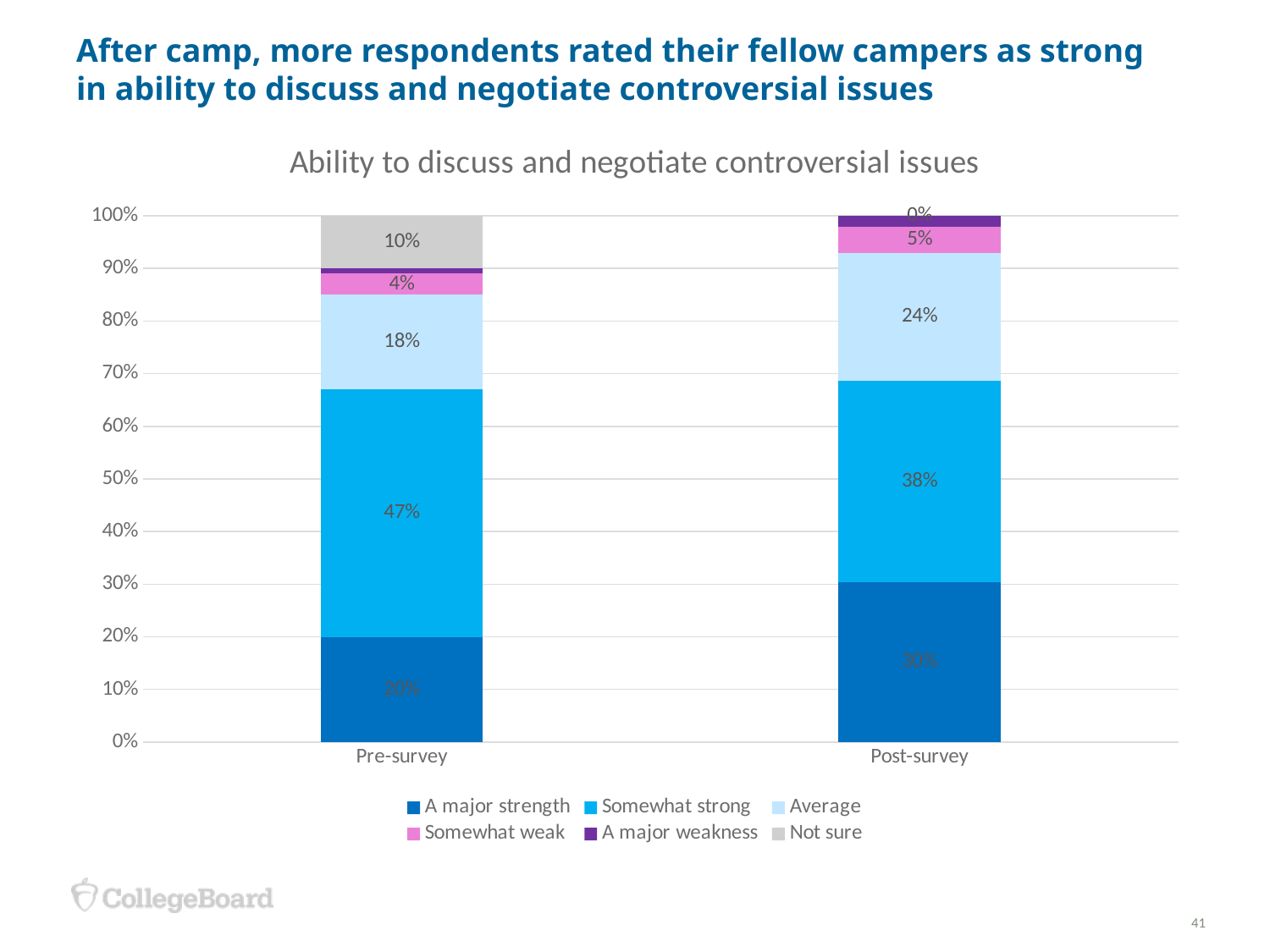
Is the 'Somewhat weak' value for Post-survey greater or less than 10%? less What is the 'Somewhat strong' value for the Pre-survey bar? 47% What type of chart is shown on the slide? stacked bar chart What percentage of Pre-survey respondents rated the ability as 'A major strength'? 20% How many bars (categories) are plotted on the x axis? 2 What is the difference between the 'Somewhat strong' values for Pre-survey (47%) and Post-survey (38%)? 9% What is the 'Average' value for the Post-survey bar? 24% What is the title of the chart? Ability to discuss and negotiate controversial issues What is the 'Not sure' value for the Pre-survey bar? 10% Which bar has the larger 'A major strength' share, Pre-survey or Post-survey? Post-survey What percentage of Post-survey respondents rated the ability as 'A major strength'? 30% How many series does the legend list? 6